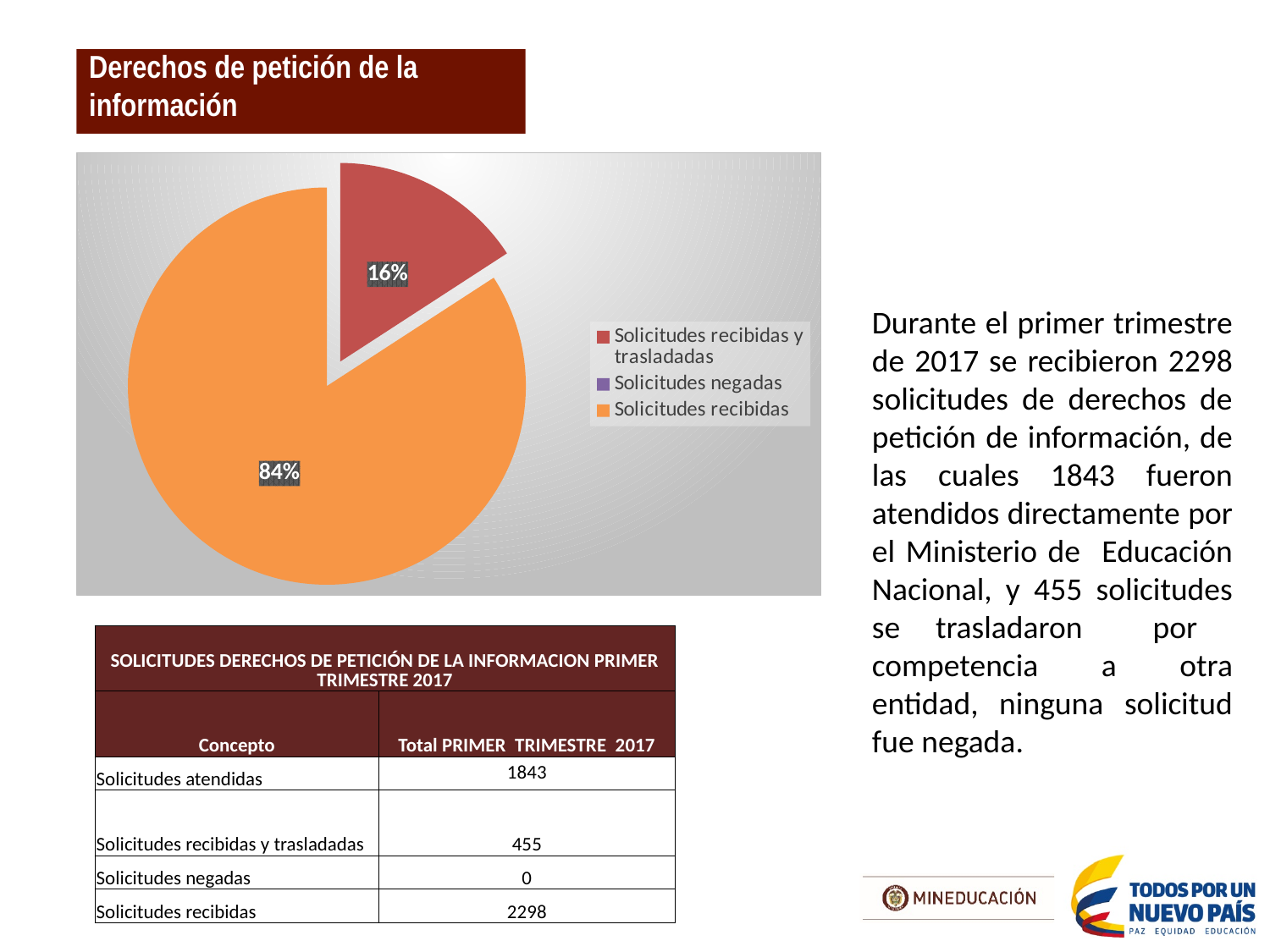
Which legend entry corresponds to the largest slice of the pie? Solicitudes recibidas What share of the pie does Solicitudes recibidas y trasladadas represent? 16% What colour is the slice labelled 84%? orange What colour is the slice labelled 16%? red How many slices with a visible percentage label are shown in the pie chart? 2 What is the difference in percentage points between the Solicitudes recibidas slice and the Solicitudes recibidas y trasladadas slice? 68% What type of chart is shown on the slide? pie chart What percentage is shown for the Solicitudes recibidas slice? 84% How many entries does the legend of the pie chart list? 3 What percentage is shown for the Solicitudes recibidas y trasladadas slice? 16% Which is larger, the Solicitudes recibidas slice or the Solicitudes recibidas y trasladadas slice? Solicitudes recibidas